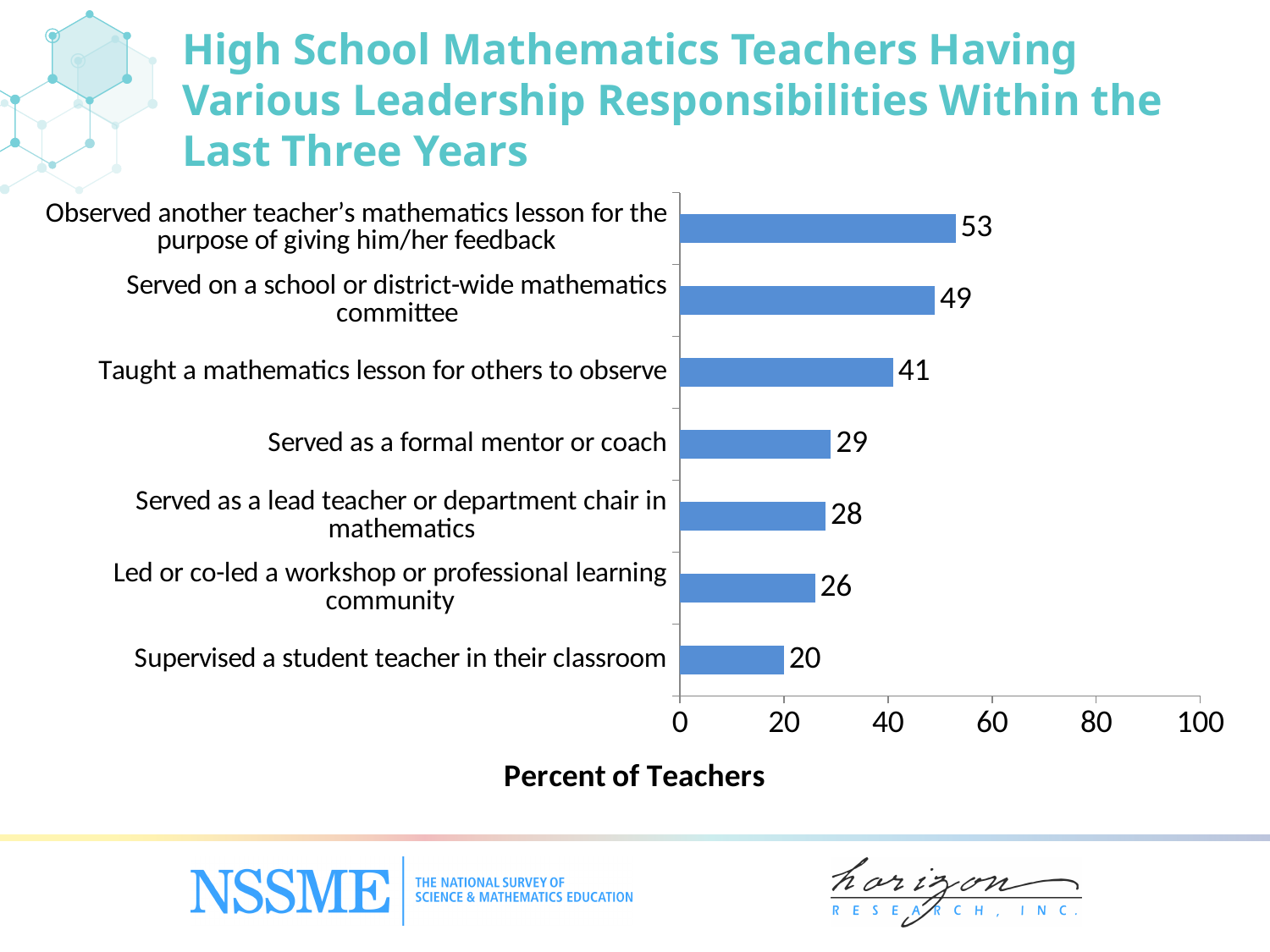
Is the value for 'Taught a mathematics lesson for others to observe' greater or less than 40? greater How many leadership responsibilities are shown in the chart? 7 Which leadership responsibility has the highest percent of teachers? Observed another teacher's mathematics lesson for the purpose of giving him/her feedback What is the label of the horizontal axis? Percent of Teachers Which leadership responsibility has the lowest percent of teachers? Supervised a student teacher in their classroom Which is larger: the percent of teachers who served as a lead teacher or department chair in mathematics, or the percent who supervised a student teacher in their classroom? Served as a lead teacher or department chair in mathematics What is the difference in percent of teachers between those who taught a mathematics lesson for others to observe and those who served as a formal mentor or coach? 12 What percent of teachers served on a school or district-wide mathematics committee? 49 What percent of teachers supervised a student teacher in their classroom? 20 What kind of chart is shown on the slide? Bar chart What percent of teachers led or co-led a workshop or professional learning community? 26 What percent of teachers observed another teacher's mathematics lesson for the purpose of giving him/her feedback? 53